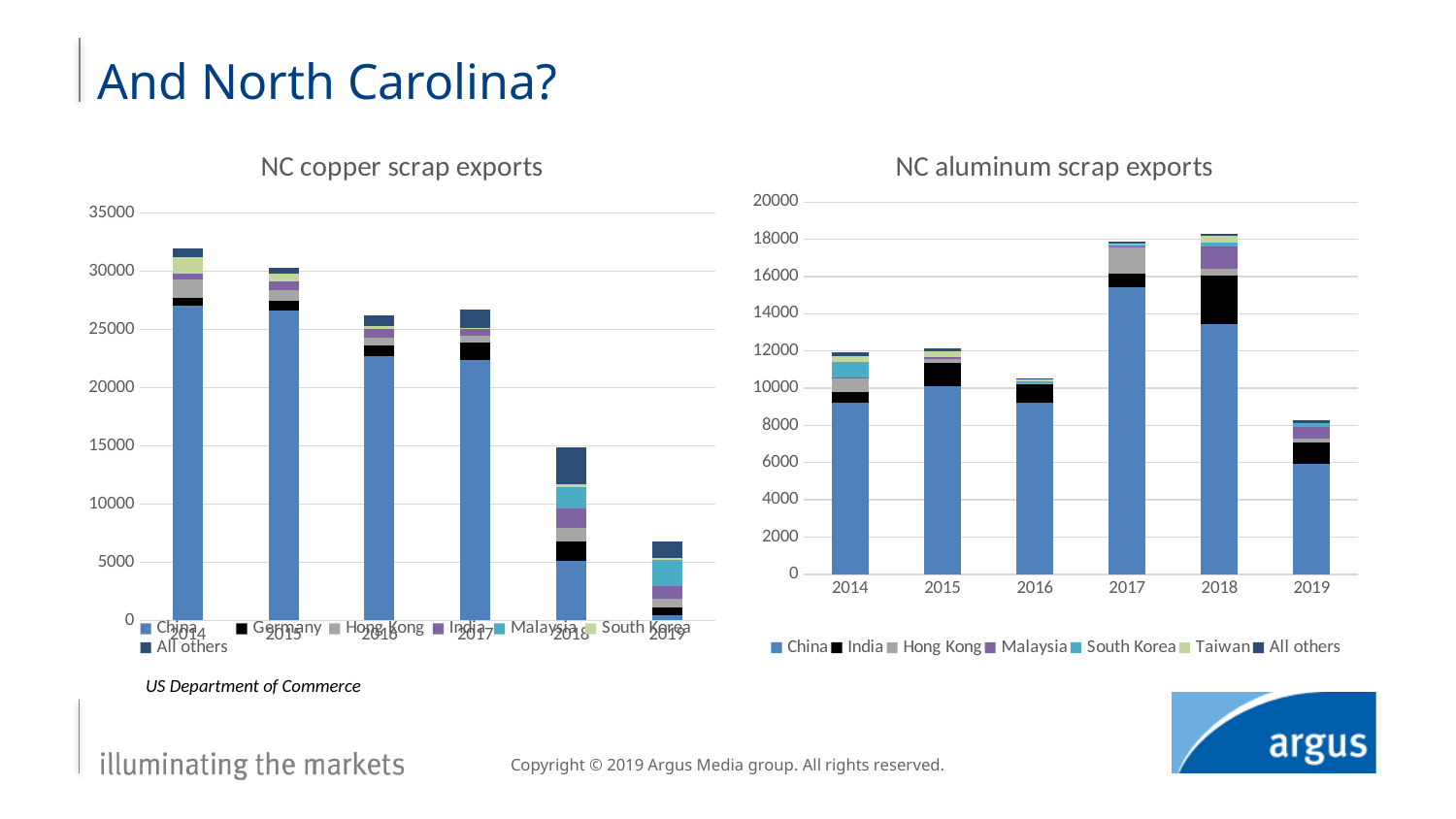
In the NC aluminum scrap exports chart, is the total for 2017 greater or less than 16000? greater In the NC aluminum scrap exports chart, which year has the shortest bar? 2019 In the NC aluminum scrap exports chart, which year has the larger total, 2014 or 2017? 2017 In the NC copper scrap exports chart, is the total for 2014 greater or less than 30000? greater In the NC copper scrap exports chart, is the total for 2019 greater or less than 10000? less In the NC copper scrap exports chart, which year has the larger total, 2015 or 2018? 2015 What type of chart is the NC copper scrap exports chart? stacked bar chart How many years are shown on the x axis of the NC aluminum scrap exports chart? 6 How many series does the legend of the NC copper scrap exports chart list? 7 In the NC copper scrap exports chart, which year has the tallest bar? 2014 Do the bar totals in the NC copper scrap exports chart generally rise or fall from 2014 to 2019? fall In the NC copper scrap exports chart, which year has the shortest bar? 2019